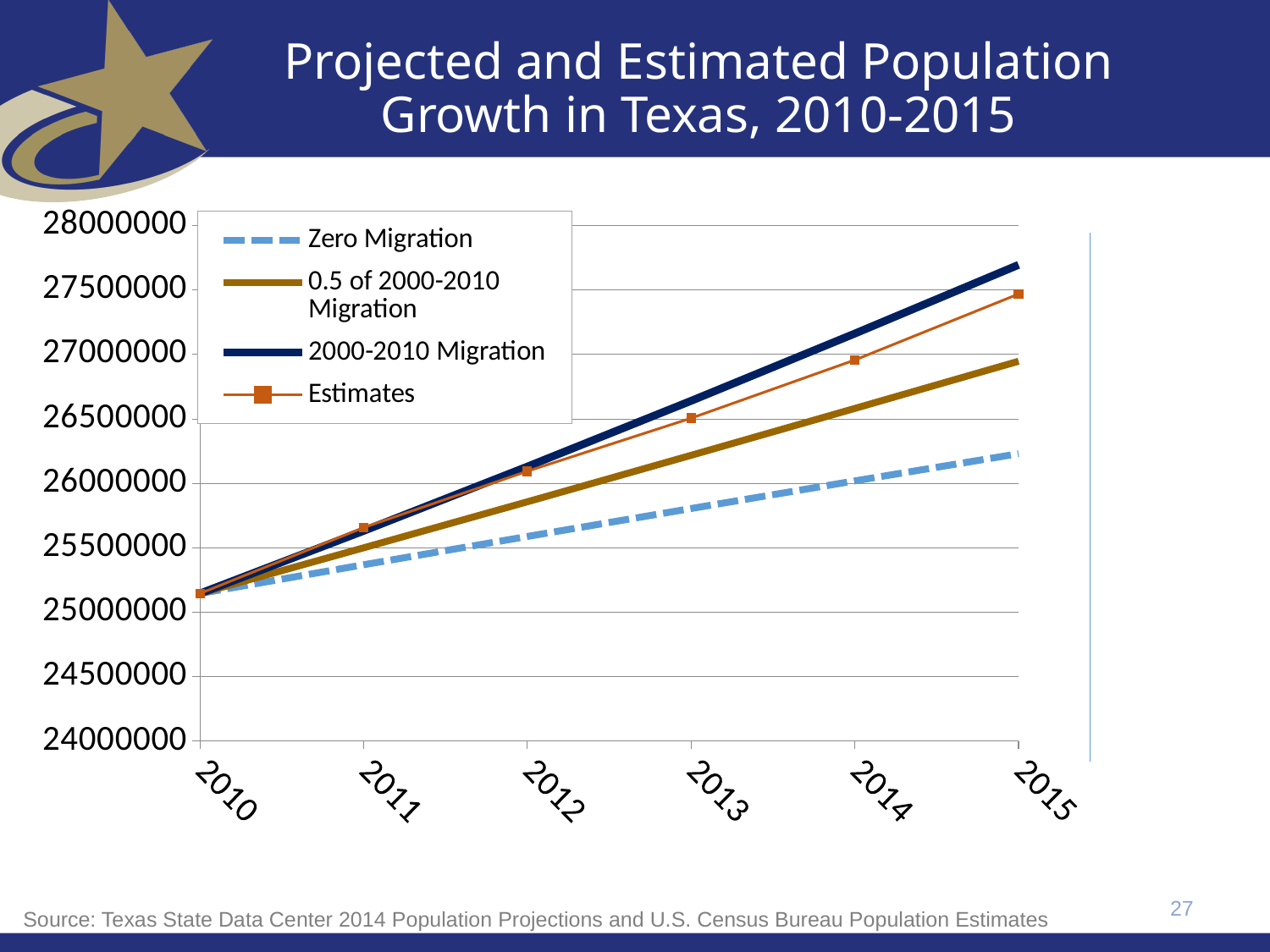
Which series is drawn with a dashed line? Zero Migration How many years are shown along the x axis? 6 Which series has the lowest value in 2015? Zero Migration Is the value for 2000-2010 Migration in 2015 greater or less than 27500000? greater What kind of chart is shown on the slide? Line chart What is the title of the chart? Projected and Estimated Population Growth in Texas, 2010-2015 Is the value for Zero Migration in 2015 greater or less than 26000000? greater Which series has the highest value in 2015? 2000-2010 Migration How many series does the legend list? 4 Do the values for the Zero Migration series rise or fall from 2010 to 2015? Rise In 2015, which is larger: the Estimates value or the 0.5 of 2000-2010 Migration value? Estimates Is the value for Zero Migration in 2013 greater or less than 25500000? greater